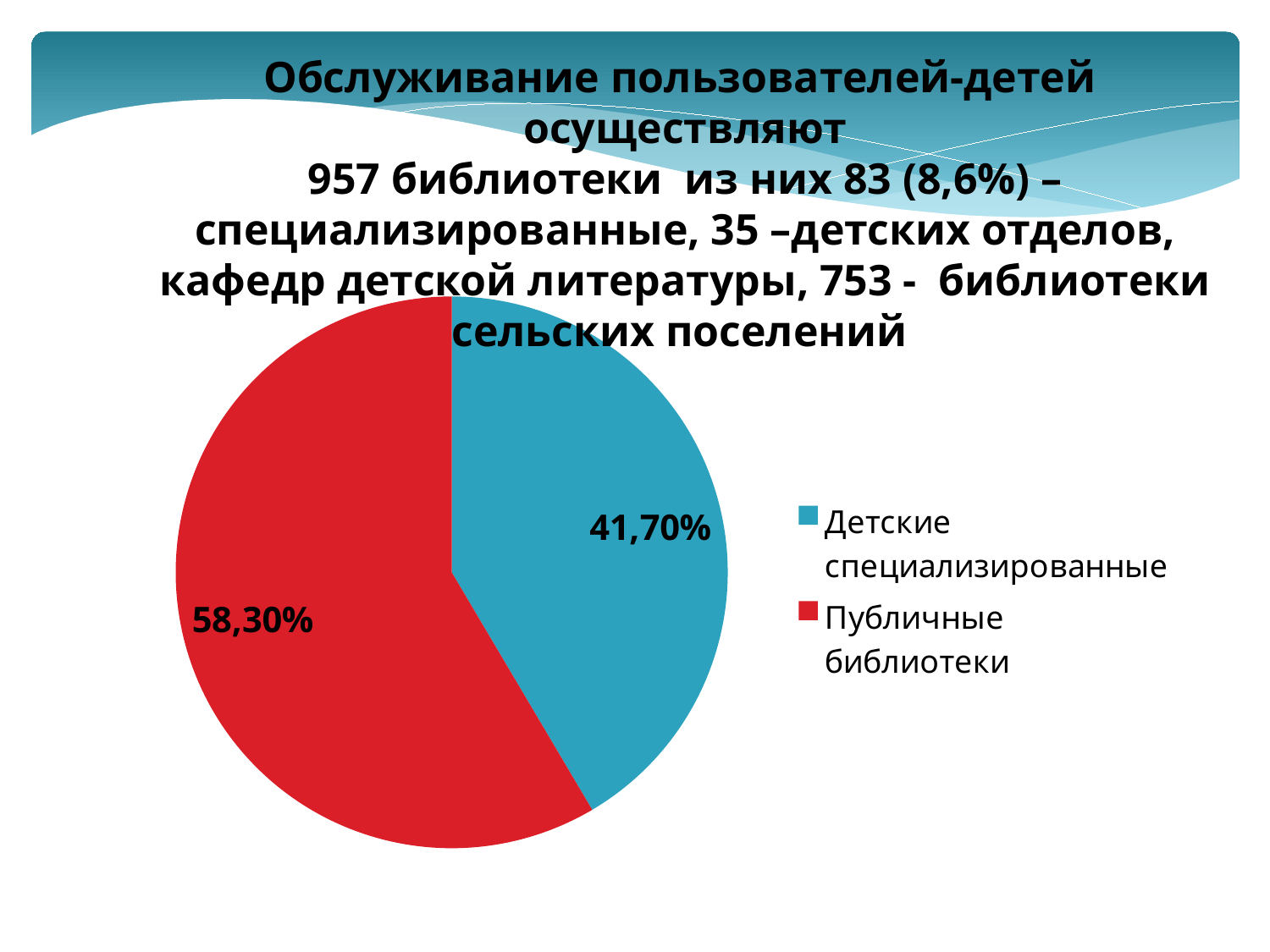
What share of the pie does Публичные библиотеки take? 58,30% Which category has the largest slice? Публичные библиотеки What kind of chart is shown on the slide? pie chart How many entries does the legend list? 2 What colour is the slice for Детские специализированные? blue How many slices does the pie chart have? 2 What is the value for Публичные библиотеки? 58,30% What colour is the slice for Публичные библиотеки? red Which is larger, the slice for Детские специализированные or the slice for Публичные библиотеки? Публичные библиотеки What is the difference between the values for Публичные библиотеки and Детские специализированные? 16,60% Which category has the smallest slice? Детские специализированные What is the value for Детские специализированные? 41,70%